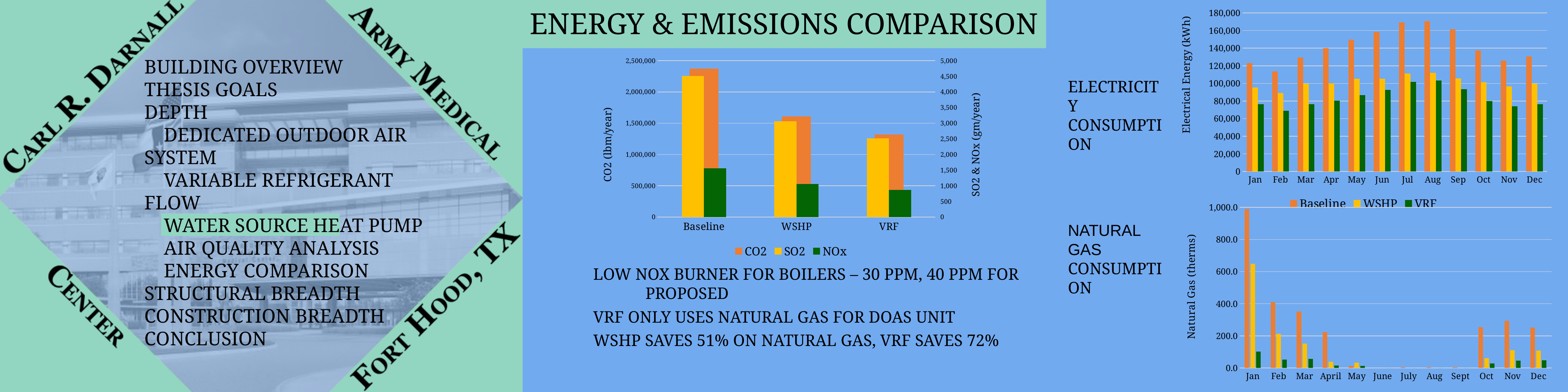
What kind of chart is the Natural Gas Consumption chart? bar chart In the Energy & Emissions Comparison chart on the left, how many series does the legend list? 3 In the Electricity Consumption chart, which series has the lowest values in every month? VRF In the Energy & Emissions Comparison chart on the left, which system has the highest CO2 emissions? Baseline In the Electricity Consumption chart, is the VRF value for Feb greater or less than 80,000? less In the Energy & Emissions Comparison chart on the left, how many systems are compared on the x axis? 3 In the Natural Gas Consumption chart, which month has the highest Baseline natural gas use? Jan In the Energy & Emissions Comparison chart on the left, which system has the lowest NOx emissions? VRF In the Energy & Emissions Comparison chart on the left, is the CO2 value for Baseline greater or less than 2,000,000? greater In the Natural Gas Consumption chart, is the Baseline value for Jan greater or less than 800.0? greater